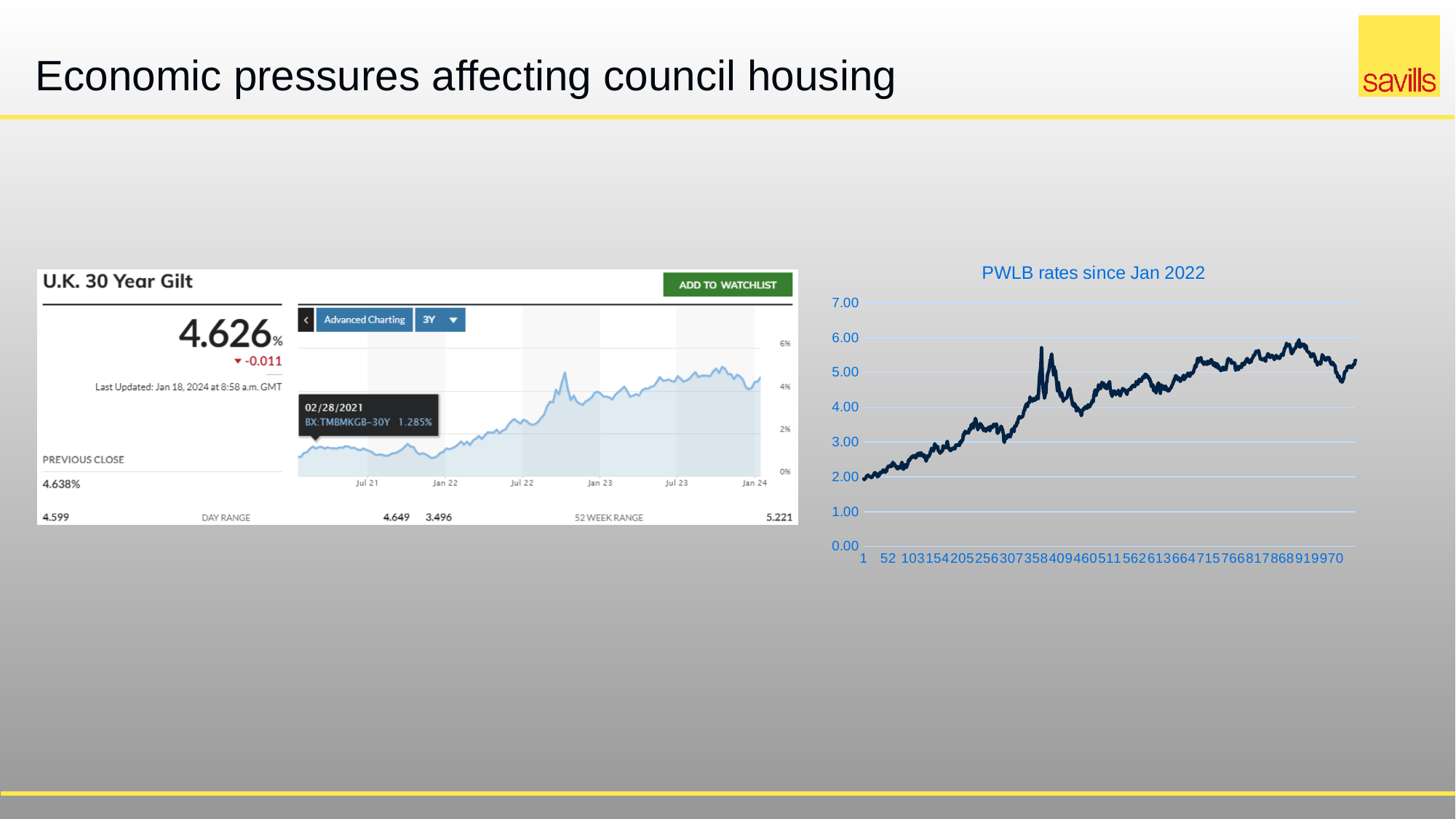
In the 'PWLB rates since Jan 2022' chart, is the value at the first point greater or less than 3.00? less In the 'U.K. 30 Year Gilt' panel, what is the previous close value? 4.638% In the 'U.K. 30 Year Gilt' panel, what is the difference between the high and low of the day range? 0.050 In the 'PWLB rates since Jan 2022' chart, is the value at the last point greater or less than 4.00? greater In the 'PWLB rates since Jan 2022' chart, do the values generally rise or fall from left to right? rise In the 'U.K. 30 Year Gilt' panel, what is the daily change shown below the current yield? -0.011 In the 'U.K. 30 Year Gilt' panel, what is the high end of the 52 week range? 5.221 In the 'U.K. 30 Year Gilt' panel, what is the current yield shown in large text? 4.626% In the 'U.K. 30 Year Gilt' panel, what is the low end of the 52 week range? 3.496 In the 'U.K. 30 Year Gilt' panel, what yield does the tooltip show for 02/28/2021? 1.285% What kind of chart is shown in the 'U.K. 30 Year Gilt' panel? line chart What kind of chart is the 'PWLB rates since Jan 2022' chart? line chart